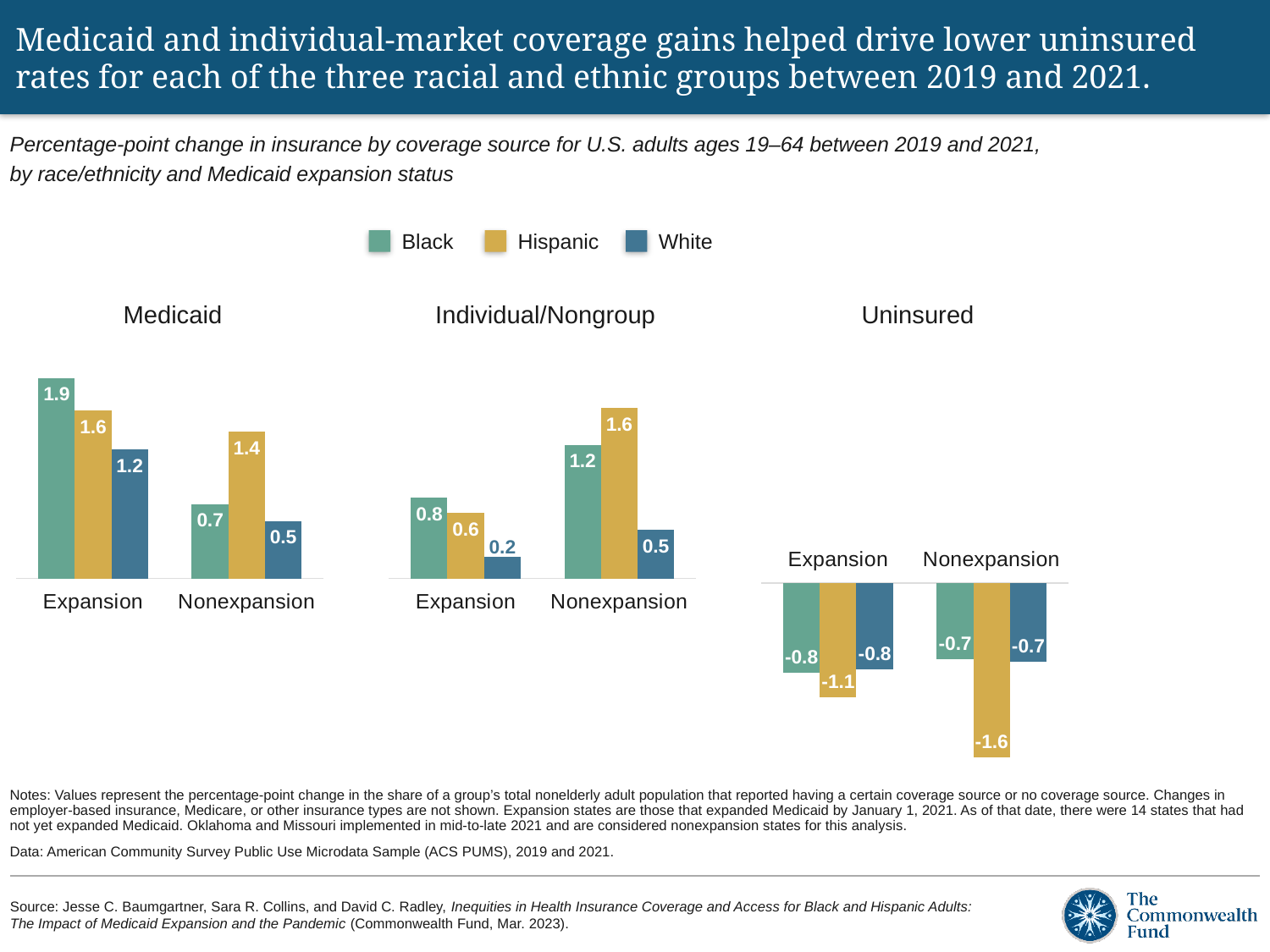
In the Medicaid chart, what is the value for White adults in nonexpansion states? 0.5 In the Medicaid chart, which group has the highest value in expansion states? Black In the Individual/Nongroup chart, what is the value for Hispanic adults in nonexpansion states? 1.6 In the Individual/Nongroup chart, which group has the lowest value in expansion states? White How many series does the legend list? 3 In the Medicaid chart, what is the value for Black adults in expansion states? 1.9 Which colour represents Hispanic adults in the legend? Gold/yellow In the Uninsured chart, which is larger in magnitude: the Hispanic value in expansion states or the Hispanic value in nonexpansion states? Nonexpansion In the Individual/Nongroup chart, what is the difference between the Hispanic values for nonexpansion and expansion states? 1.0 What kind of chart is the Medicaid chart? Bar chart In the Medicaid chart, what is the difference between the Black and White values in expansion states? 0.7 In the Uninsured chart, what is the value for Hispanic adults in nonexpansion states? -1.6